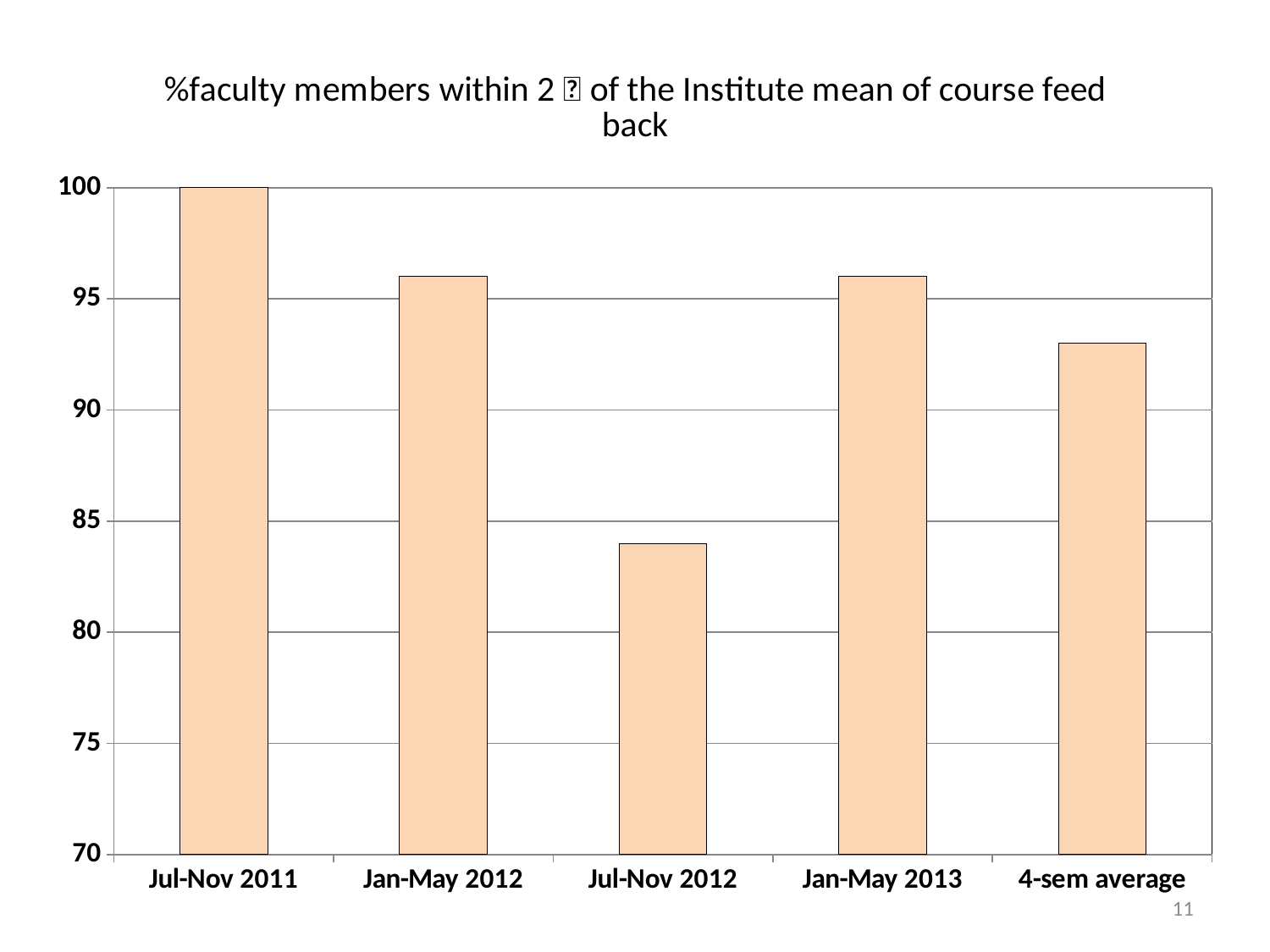
Which category has the highest value? Jul-Nov 2011 Is the value for Jan-May 2012 greater or less than 95? greater Is the value for Jul-Nov 2012 greater or less than 85? less Do the values rise or fall from Jul-Nov 2011 to Jul-Nov 2012? fall Is the value for 4-sem average greater or less than 95? less What kind of chart is shown on the slide? bar chart Which is larger, the value for 4-sem average or the value for Jul-Nov 2012? 4-sem average Which is larger, the value for Jan-May 2012 or the value for Jul-Nov 2012? Jan-May 2012 How many categories are shown on the x axis? 5 Which category has the lowest value? Jul-Nov 2012 What is the value for Jul-Nov 2011? 100